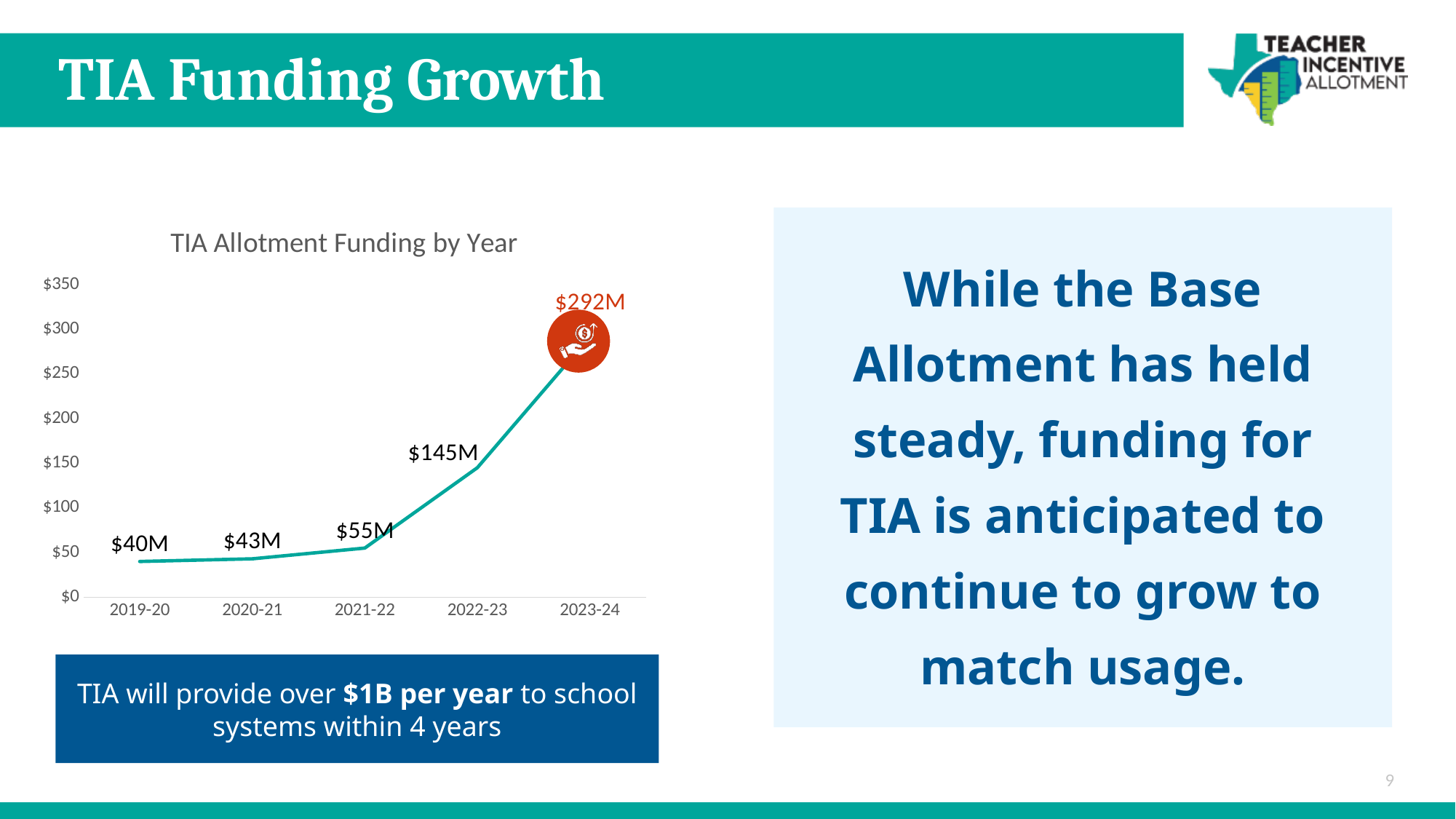
What is the TIA allotment funding for 2021-22? $55M What is the TIA allotment funding for 2023-24? $292M Which year has the highest TIA allotment funding? 2023-24 What kind of chart is shown on the slide? line chart Does TIA allotment funding rise or fall from 2019-20 to 2023-24? rise Which year has the lowest TIA allotment funding? 2019-20 Is the funding for 2022-23 greater or less than $100? greater How many years are plotted on the chart? 5 Which year has higher funding, 2021-22 or 2022-23? 2022-23 What is the TIA allotment funding for 2019-20? $40M What is the difference in funding between 2023-24 and 2022-23? $147M What is the difference in funding between 2020-21 and 2019-20? $3M